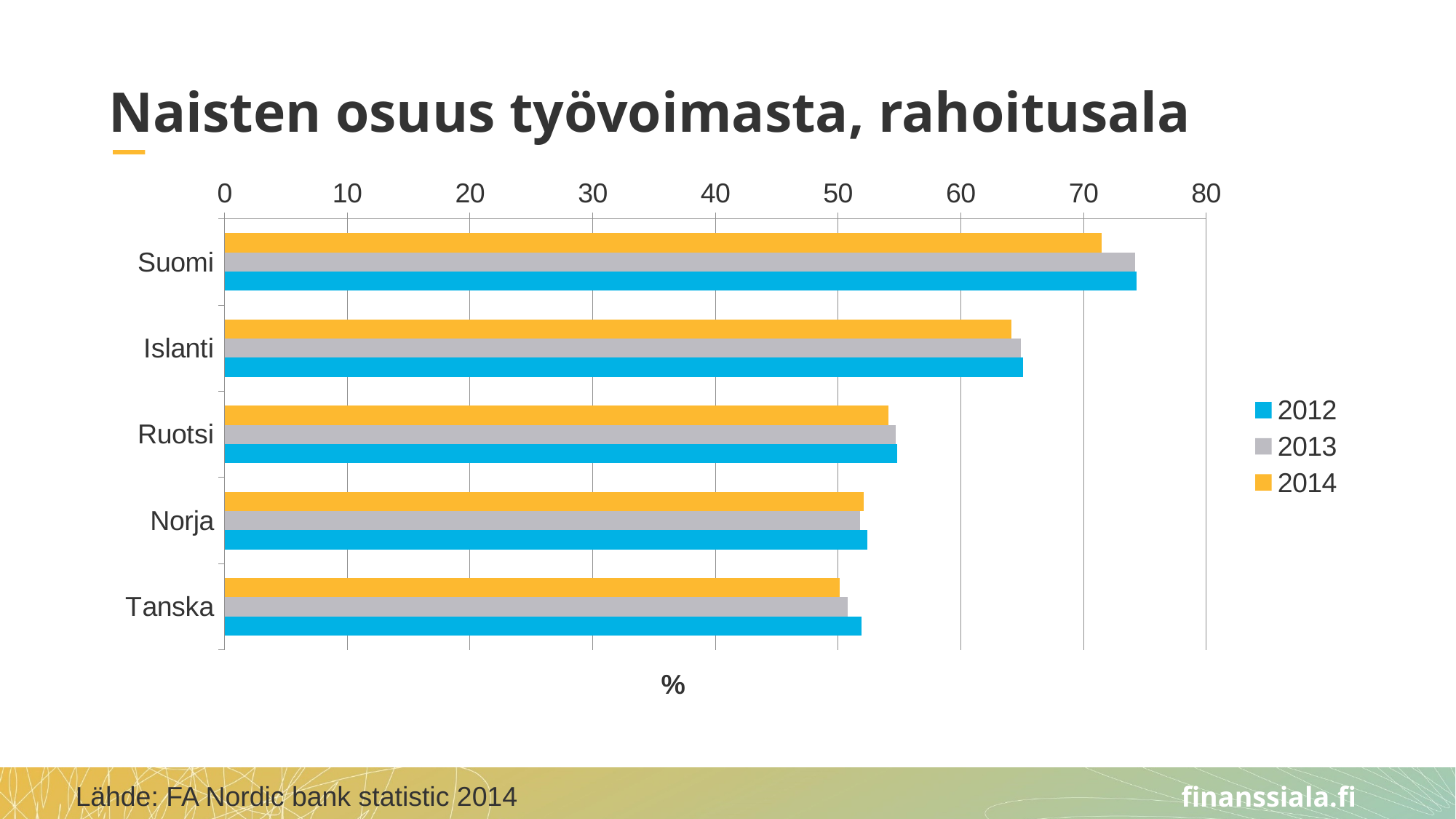
Which country has the lowest value for 2014? Tanska What kind of chart is shown on the slide? bar chart Which is larger, the 2012 value for Ruotsi or the 2012 value for Norja? Ruotsi What is the label on the horizontal axis of the chart? % How many countries are shown on the chart? 5 Which is larger, the 2014 value for Suomi or the 2014 value for Islanti? Suomi Is the value for Suomi in 2012 greater or less than 80? less How many series does the legend list? 3 Is the value for Islanti in 2012 greater or less than 60? greater Is the value for Suomi in 2014 greater or less than 70? greater Which country has the highest value for 2014? Suomi